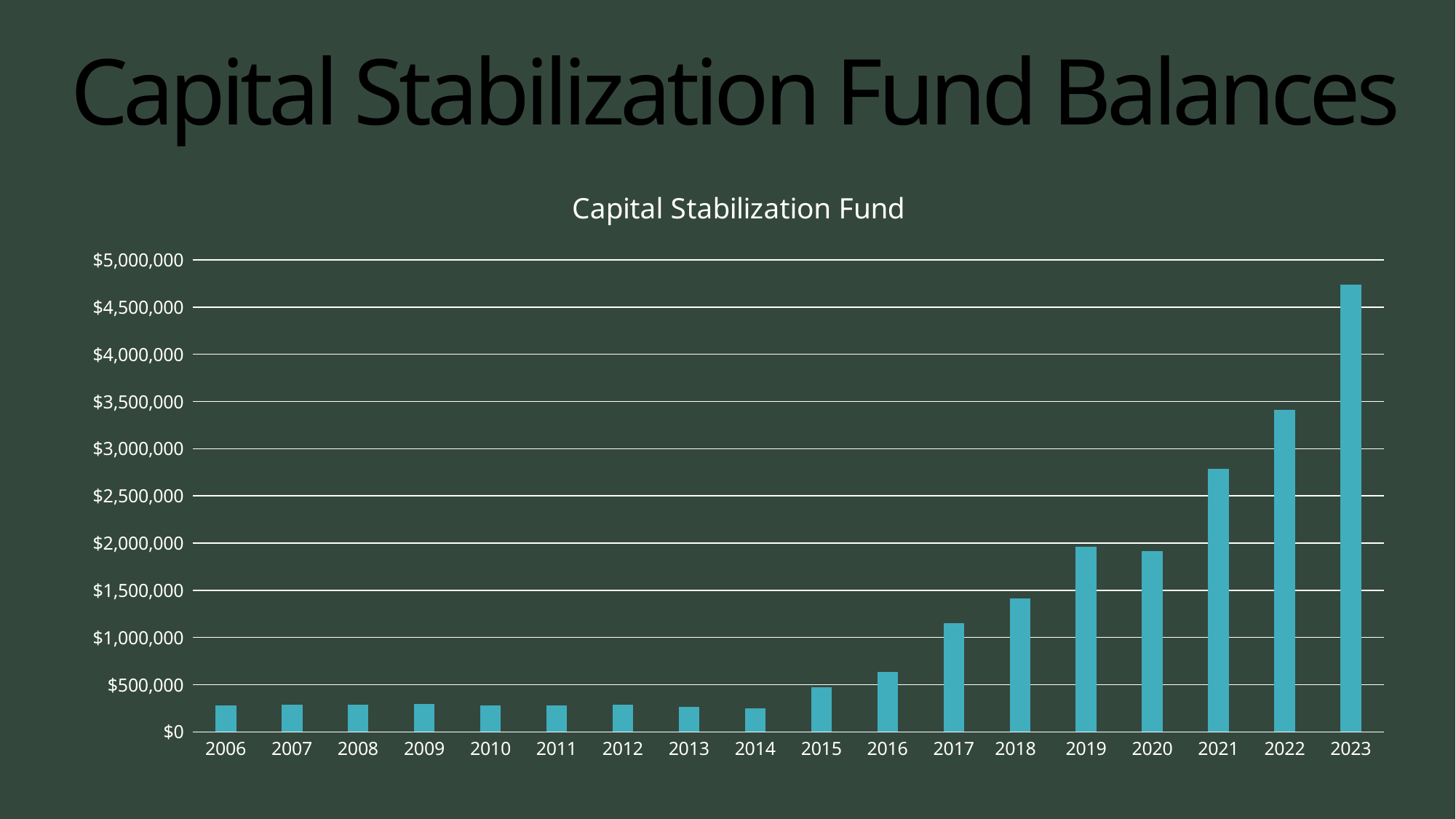
Is the value for 2023 greater or less than $4,500,000? greater Which year has the highest Capital Stabilization Fund balance? 2023 How many years are shown on the x axis of the chart? 18 Is the value for 2006 greater or less than $500,000? less Is the value for 2022 greater or less than $3,500,000? less What is the title of the chart? Capital Stabilization Fund Which year has the larger fund balance, 2016 or 2017? 2017 Do the fund balances generally rise or fall from 2006 to 2023? Rise Which year has the larger fund balance, 2021 or 2022? 2022 What kind of chart is shown on the slide? Bar chart